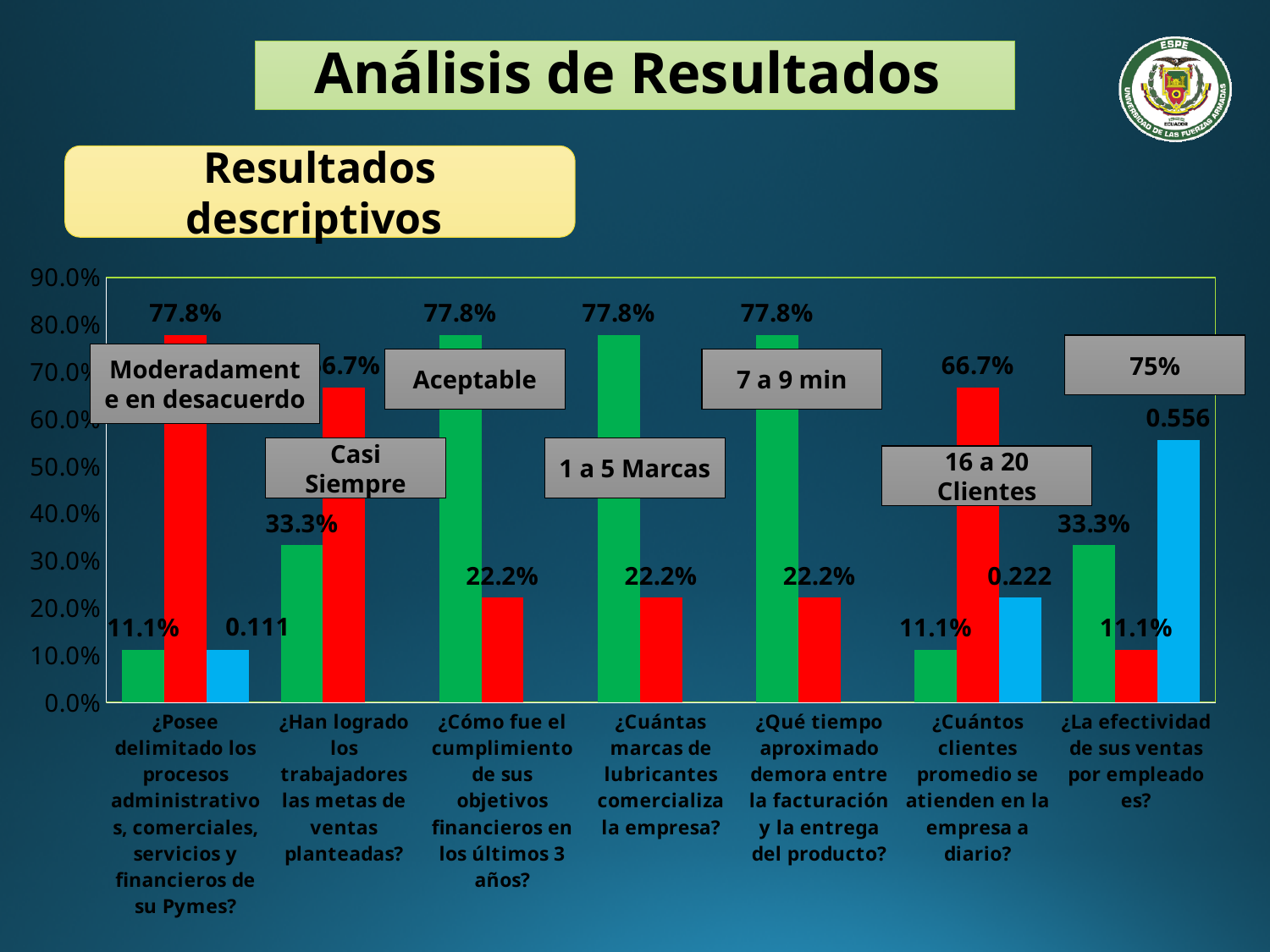
Which bar is the tallest for '¿La efectividad de sus ventas por empleado es?'? the blue bar What is the value of the red bar for '¿Posee delimitado los procesos administrativos, comerciales, servicios y financieros de su Pymes?'? 77.8% What is the value labelled on the blue bar for '¿La efectividad de sus ventas por empleado es?'? 0.556 What kind of chart is shown on the slide? bar chart What is the value of the red bar for '¿Cuántos clientes promedio se atienden en la empresa a diario?'? 66.7% For '¿Cuántos clientes promedio se atienden en la empresa a diario?', which is larger, the green bar or the red bar? the red bar What is the value labelled on the blue bar for '¿Cuántos clientes promedio se atienden en la empresa a diario?'? 0.222 What is the value of the green bar for '¿Han logrado los trabajadores las metas de ventas planteadas?'? 33.3% How many survey questions (categories) are shown along the x axis of the chart? 7 Which bar is the lowest for '¿La efectividad de sus ventas por empleado es?'? the red bar (11.1%) Is the red bar for '¿Han logrado los trabajadores las metas de ventas planteadas?' greater or less than 60.0%? greater What is the difference between the green bar and the red bar for '¿Cómo fue el cumplimiento de sus objetivos financieros en los últimos 3 años?'? 55.6%